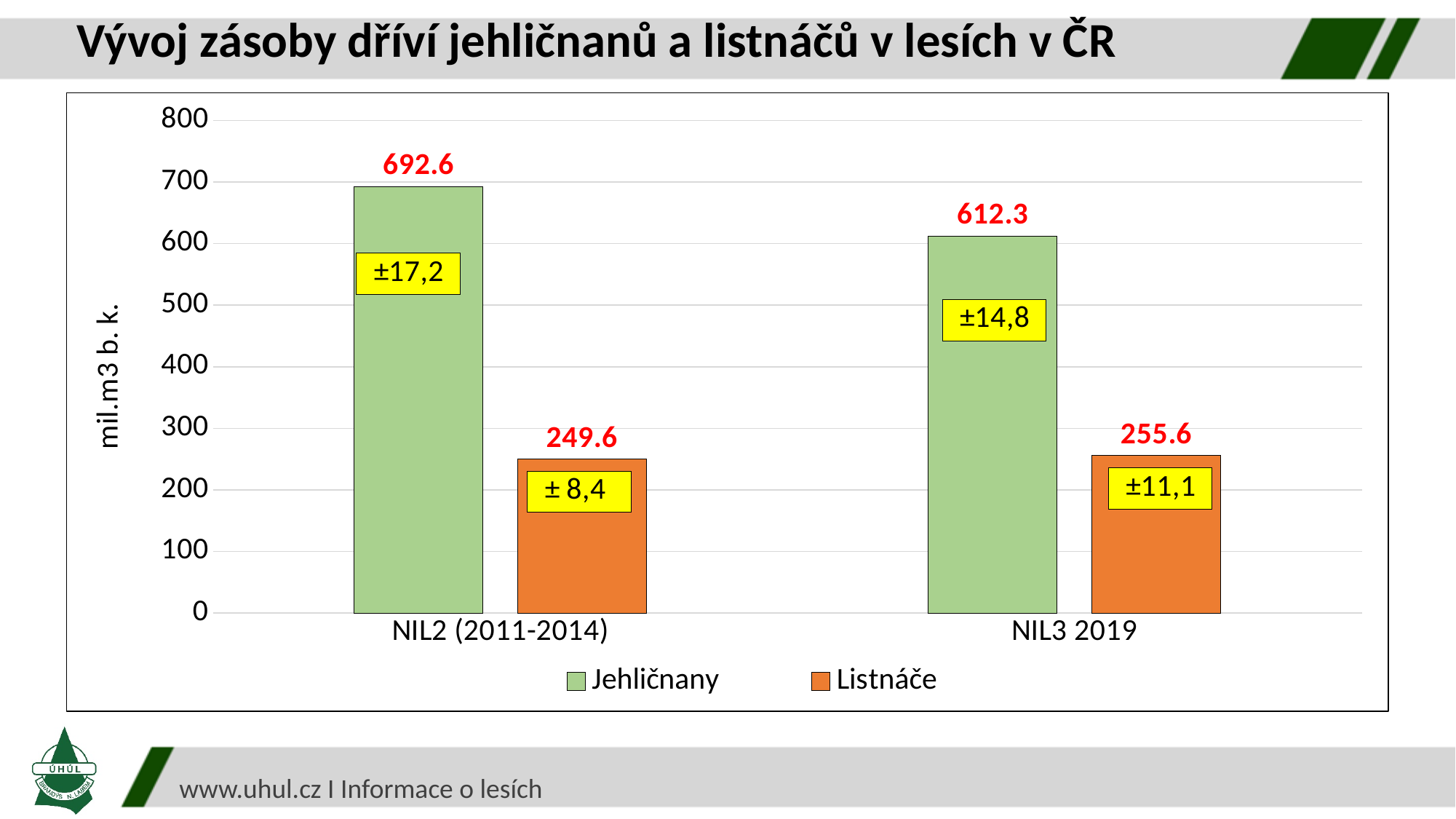
What is the difference between the Jehličnany values for NIL2 (2011-2014) and NIL3 2019? 80.3 What kind of chart is shown on the slide? Bar chart Which bar has the highest value on the chart? Jehličnany, NIL2 (2011-2014) How many series does the legend list? 2 What is the value for Listnáče in NIL2 (2011-2014)? 249.6 Which is larger: Listnáče in NIL2 (2011-2014) or Listnáče in NIL3 2019? Listnáče in NIL3 2019 What is the label of the y axis? mil.m3 b. k. How many categories are shown on the x axis? 2 What is the value for Jehličnany in NIL3 2019? 612.3 What is the value for Listnáče in NIL3 2019? 255.6 What is the value for Jehličnany in NIL2 (2011-2014)? 692.6 Which bar has the lowest value on the chart? Listnáče, NIL2 (2011-2014)